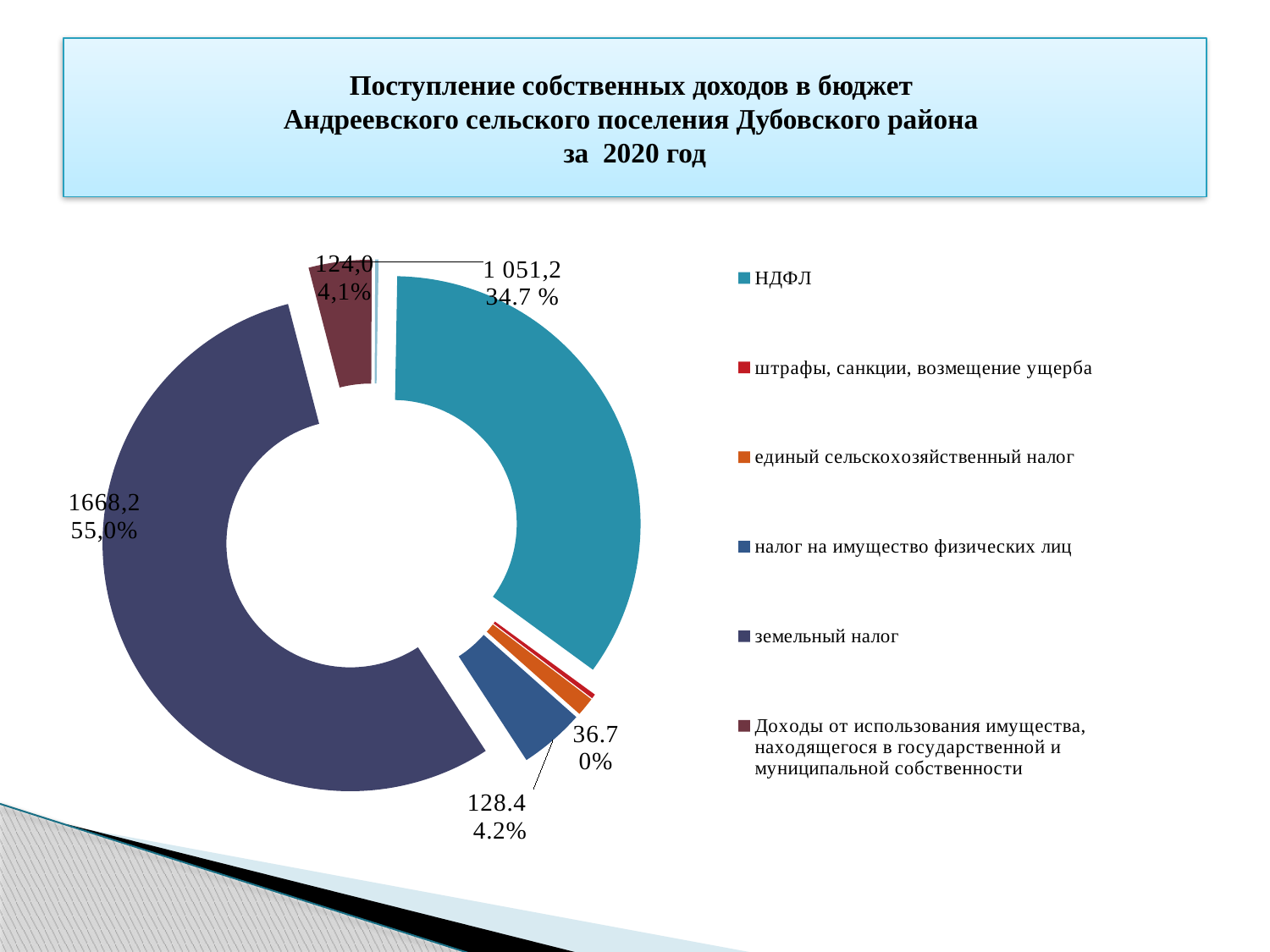
How many categories does the legend list? 6 What is the value shown for Доходы от использования имущества, находящегося в государственной и муниципальной собственности? 124,0 What is the value shown for земельный налог? 1668,2 Which is larger: НДФЛ or налог на имущество физических лиц? НДФЛ What is the difference between the values for земельный налог and НДФЛ? 617,0 Which category has the largest slice? земельный налог What kind of chart is shown on the slide? pie (doughnut) chart What share of the total does НДФЛ account for? 34.7 % What share of the total does земельный налог account for? 55,0% What share of the total does налог на имущество физических лиц account for? 4.2% What is the value shown for НДФЛ? 1 051,2